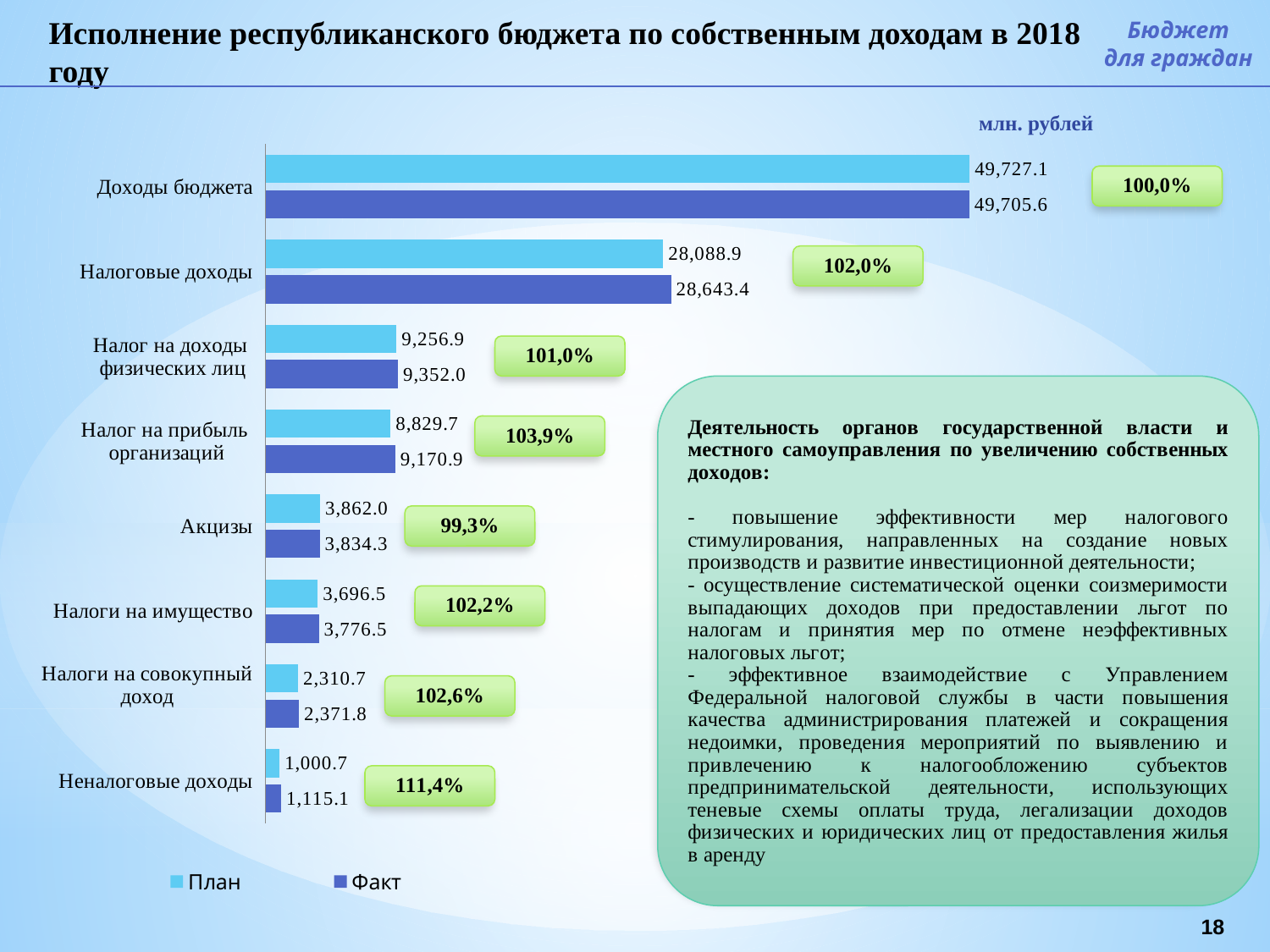
How many categories are shown on the chart? 8 Which category has the highest Факт value? Доходы бюджета Which is larger for Акцизы, the План value or the Факт value? План What is the Факт value for Налоговые доходы? 28,643.4 Which category has the lowest План value? Неналоговые доходы How many series does the legend list? 2 What is the План value for Неналоговые доходы? 1,000.7 By how much does the Факт value exceed the План value for Налог на прибыль организаций? 341.2 What kind of chart is shown on the slide? Bar chart What is the План value for Доходы бюджета? 49,727.1 What is the Факт value for Акцизы? 3,834.3 What unit is indicated above the chart? млн. рублей